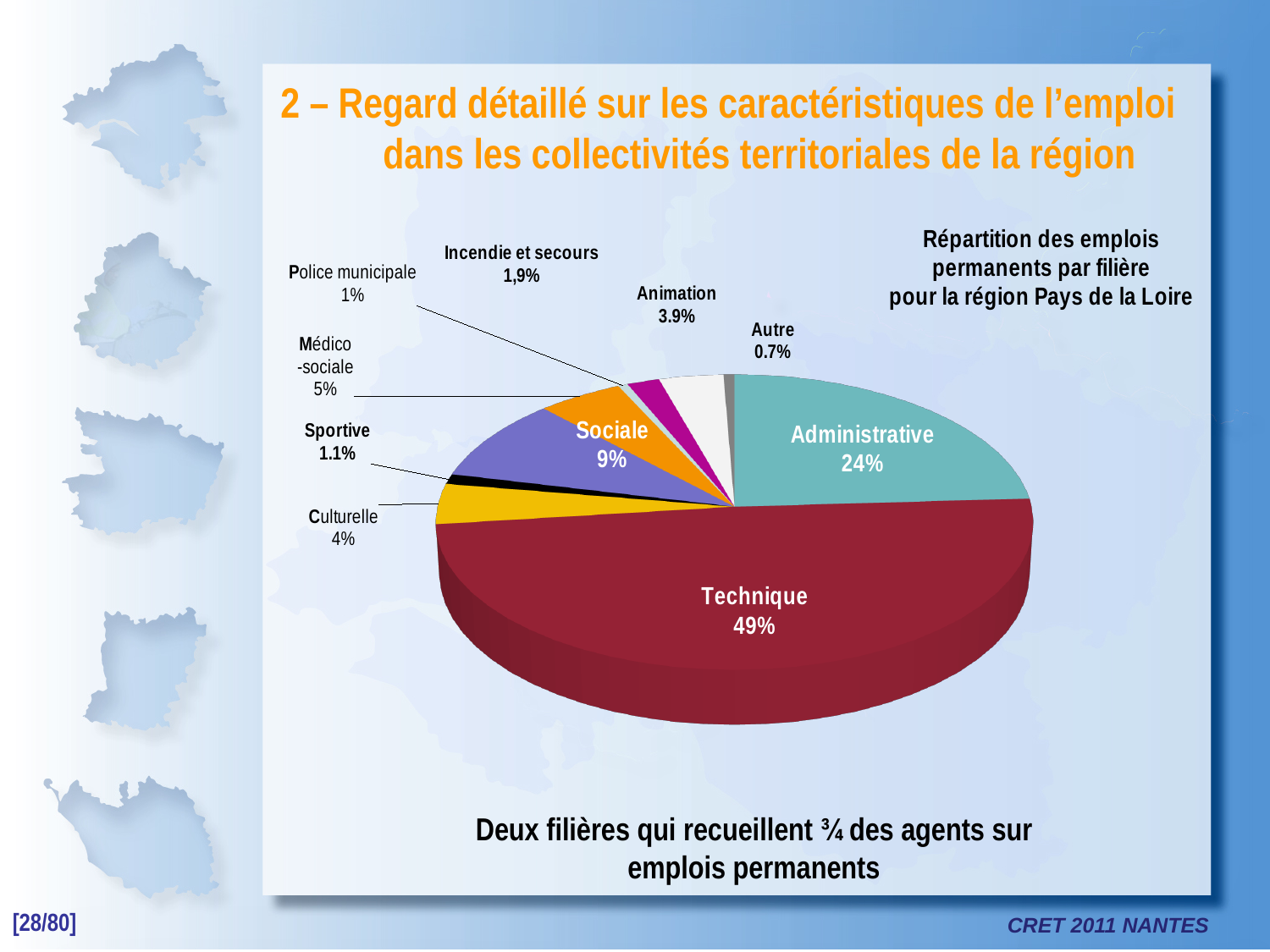
Which filière has the largest share of the pie? Technique What type of chart is shown on the slide? Pie chart What percentage is shown for Sociale? 9% What is the value shown for Autre? 0.7% Which is larger, the share for Médico-sociale or the share for Culturelle? Médico-sociale What is the difference between the Technique and Administrative shares? 25% What is the value shown for Administrative? 24% What is the value shown for Incendie et secours? 1,9% How many slices does the pie chart have? 10 What share of the pie does the Technique slice represent? 49% What is the title of the chart? Répartition des emplois permanents par filière pour la région Pays de la Loire